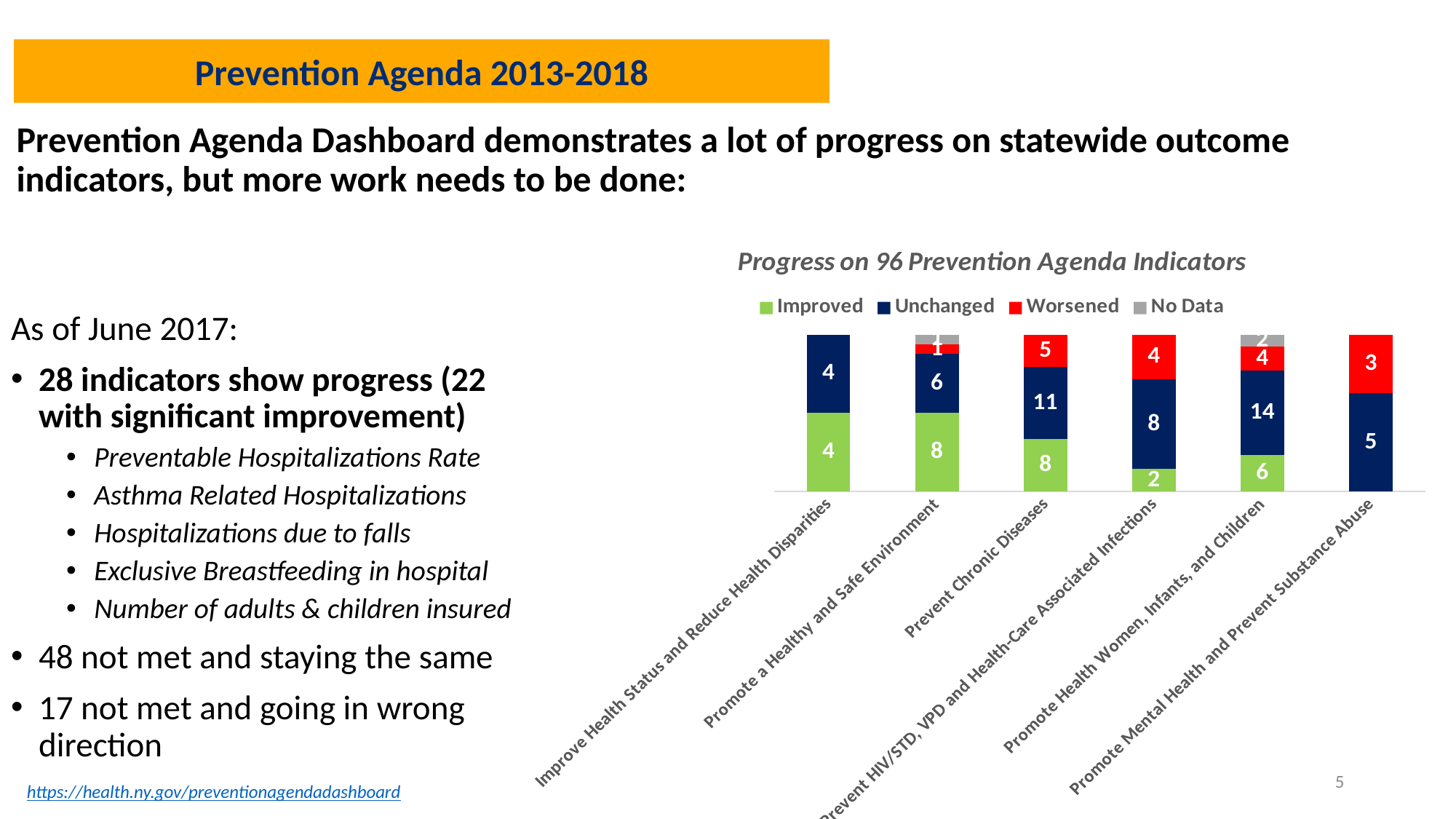
What kind of chart is shown on the slide? Stacked bar chart How many indicators Improved for Prevent Chronic Diseases? 8 What is the title of the chart? Progress on 96 Prevention Agenda Indicators How many series does the chart legend list? 4 What is the total number of indicators in the Prevent Chronic Diseases bar? 24 How many indicators Worsened for Promote Mental Health and Prevent Substance Abuse? 3 What is the difference between the Unchanged and Improved counts for Prevent Chronic Diseases? 3 How many categories are shown on the x axis of the chart? 6 How many indicators are Unchanged for Promote Health Women, Infants, and Children? 14 Which category has the lowest number of Improved indicators among those with an Improved segment? Prevent HIV/STD, VPD and Health-Care Associated Infections Which category has the highest number of Unchanged indicators? Promote Health Women, Infants, and Children Which is larger: the Worsened count for Prevent Chronic Diseases or the Worsened count for Prevent HIV/STD, VPD and Health-Care Associated Infections? Prevent Chronic Diseases